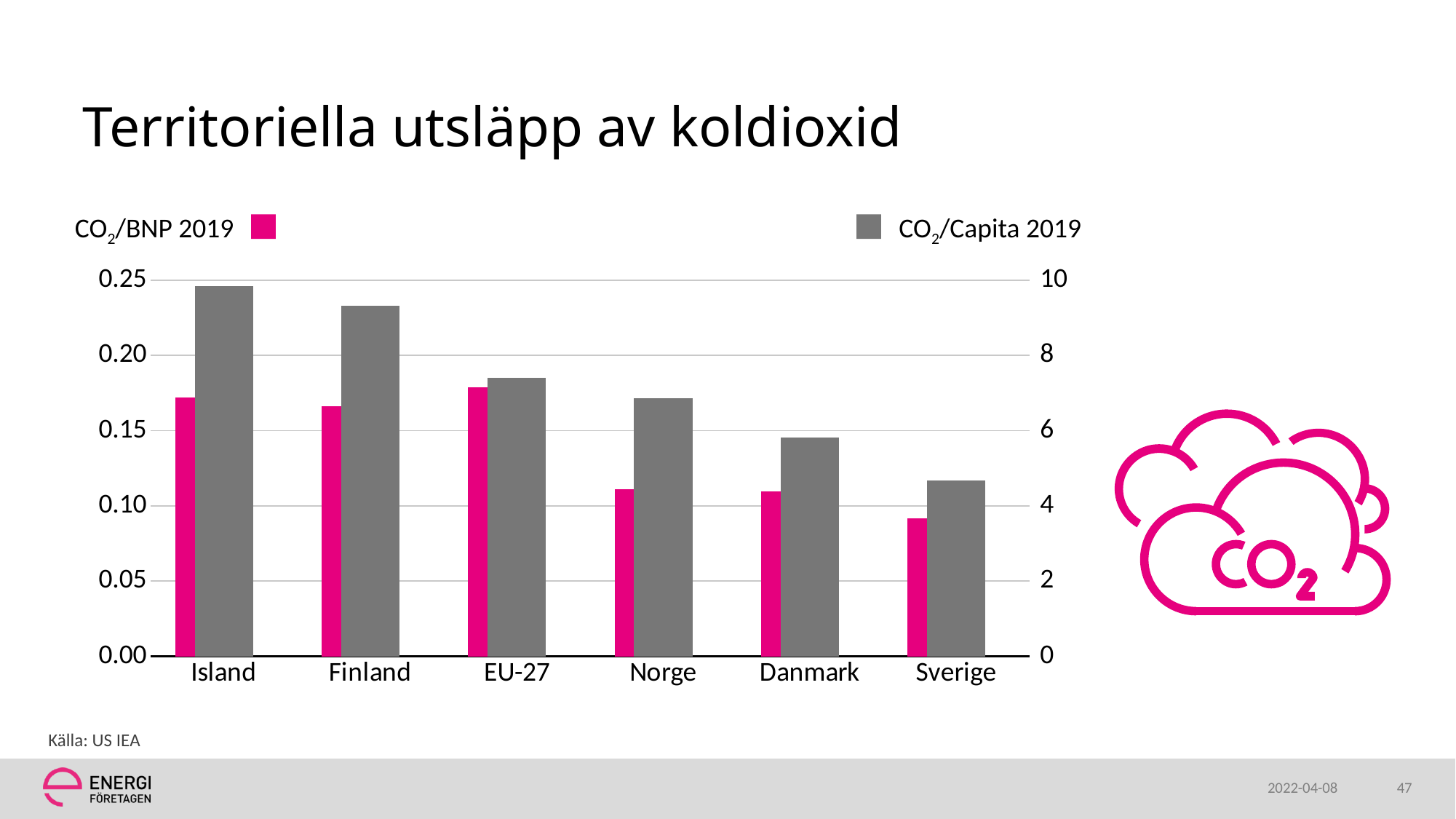
Is the CO2/BNP 2019 value for Island greater or less than 0.15? greater How many series does the chart's legend list? 2 Which has the larger CO2/BNP 2019 value, Finland or Norge? Finland Is the CO2/Capita 2019 value for Island greater or less than 8? greater How many countries or regions are shown on the x axis of the chart? 6 Is the CO2/Capita 2019 value for Norge greater or less than 6? greater Which category has the highest CO2/Capita 2019 value? Island What kind of chart is shown on the slide? bar chart Which category has the lowest CO2/Capita 2019 value? Sverige Do the CO2/Capita 2019 values rise or fall from left to right along the x axis? fall Which category has the lowest CO2/BNP 2019 value? Sverige